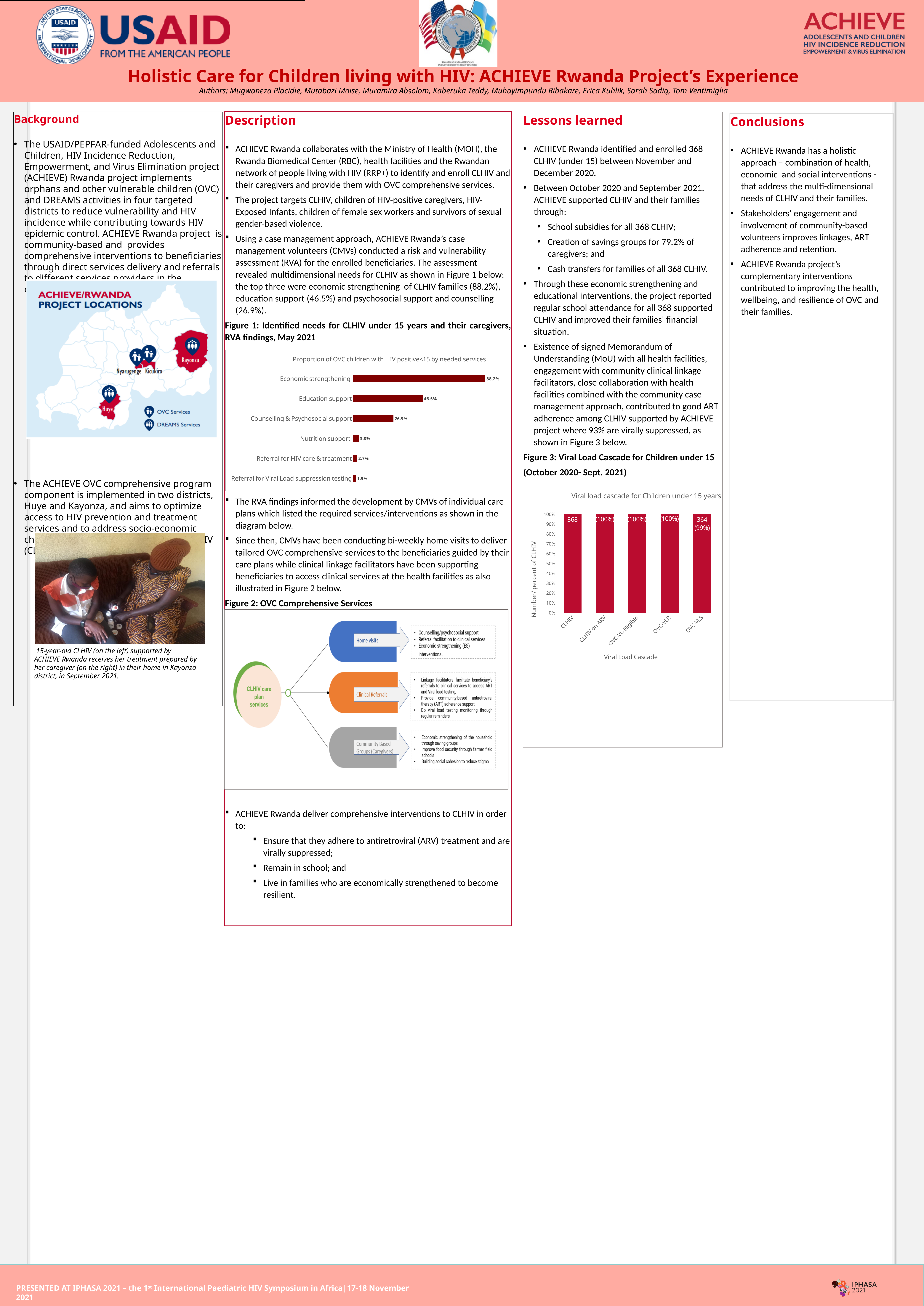
In the chart titled 'Viral load cascade for Children under 15 years', how many bars are shown along the x axis? 5 In the chart titled 'Proportion of OVC children with HIV positive<15 by needed services', what is the difference between Economic strengthening and Education support? 41.7% In the chart titled 'Proportion of OVC children with HIV positive<15 by needed services', which needed service has the highest proportion? Economic strengthening In the chart titled 'Viral load cascade for Children under 15 years', what is the number shown for OVC-VLS? 364 What kind of chart is the 'Proportion of OVC children with HIV positive<15 by needed services' chart? Bar chart In the chart titled 'Proportion of OVC children with HIV positive<15 by needed services', which needed service has the lowest proportion? Referral for Viral Load suppression testing In the chart titled 'Proportion of OVC children with HIV positive<15 by needed services', what is the value for Nutrition support? 3.8% In the chart titled 'Proportion of OVC children with HIV positive<15 by needed services', how many needed services are shown? 6 In the chart titled 'Viral load cascade for Children under 15 years', what percentage is shown for OVC-VLS? 99% In the chart titled 'Viral load cascade for Children under 15 years', what is the number shown for CLHIV? 368 In the chart titled 'Proportion of OVC children with HIV positive<15 by needed services', what is the value for Education support? 46.5% In the chart titled 'Proportion of OVC children with HIV positive<15 by needed services', what is the value for Economic strengthening? 88.2%